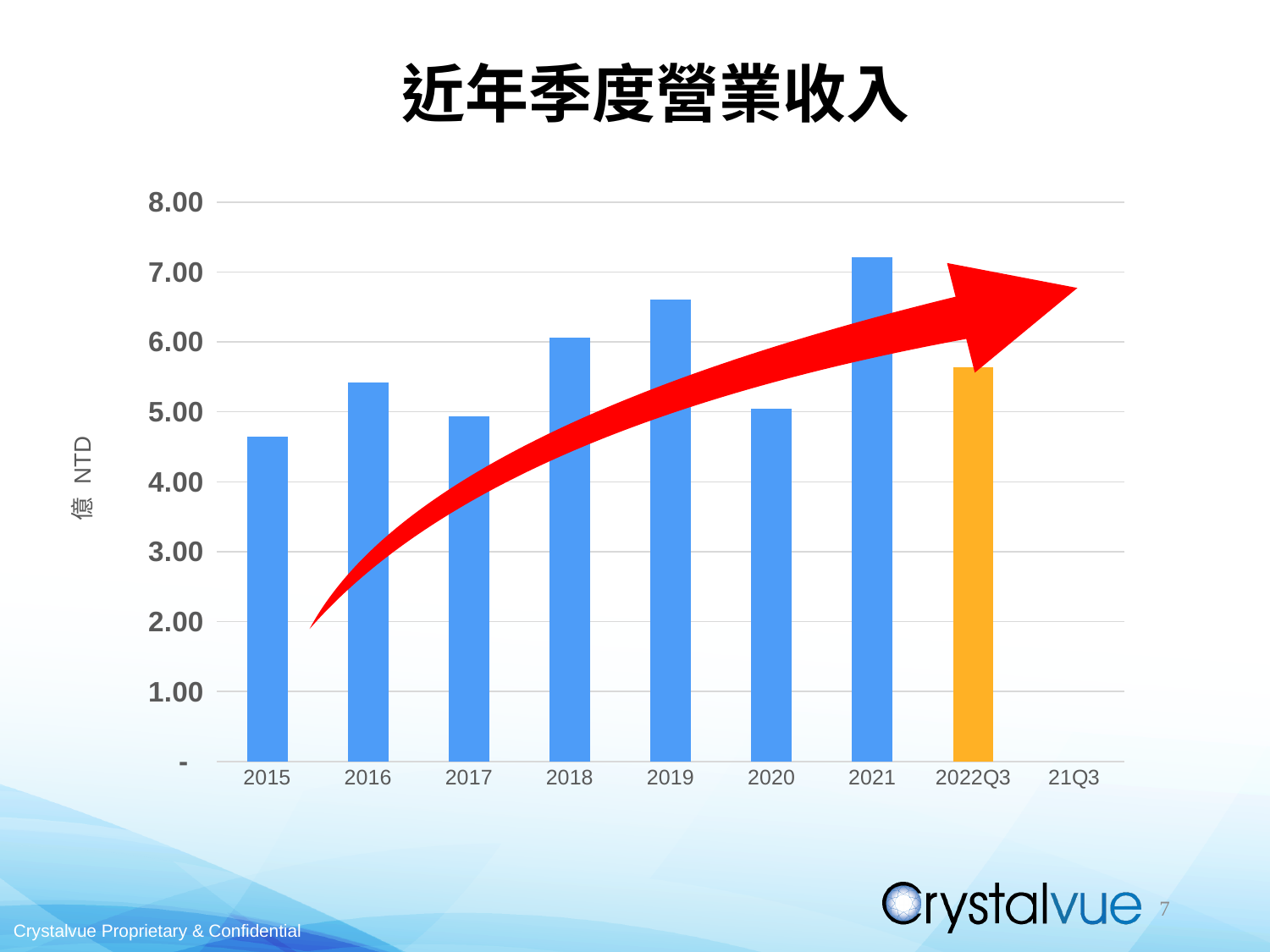
Is the value for 2022Q3 greater or less than 6.00? less What is the label on the vertical axis of the chart? 億 NTD Which category has the lowest bar in the chart? 2015 Is the value for 2019 greater or less than 6.00? greater Which is larger, the value for 2018 or the value for 2020? 2018 Which is larger, the value for 2019 or the value for 2016? 2019 Is the value for 2021 greater or less than 7.00? greater What colour is the bar for 2022Q3? orange Which year has the highest bar in the chart? 2021 What kind of chart is shown on the slide? bar chart Which is larger, the value for 2021 or the value for 2022Q3? 2021